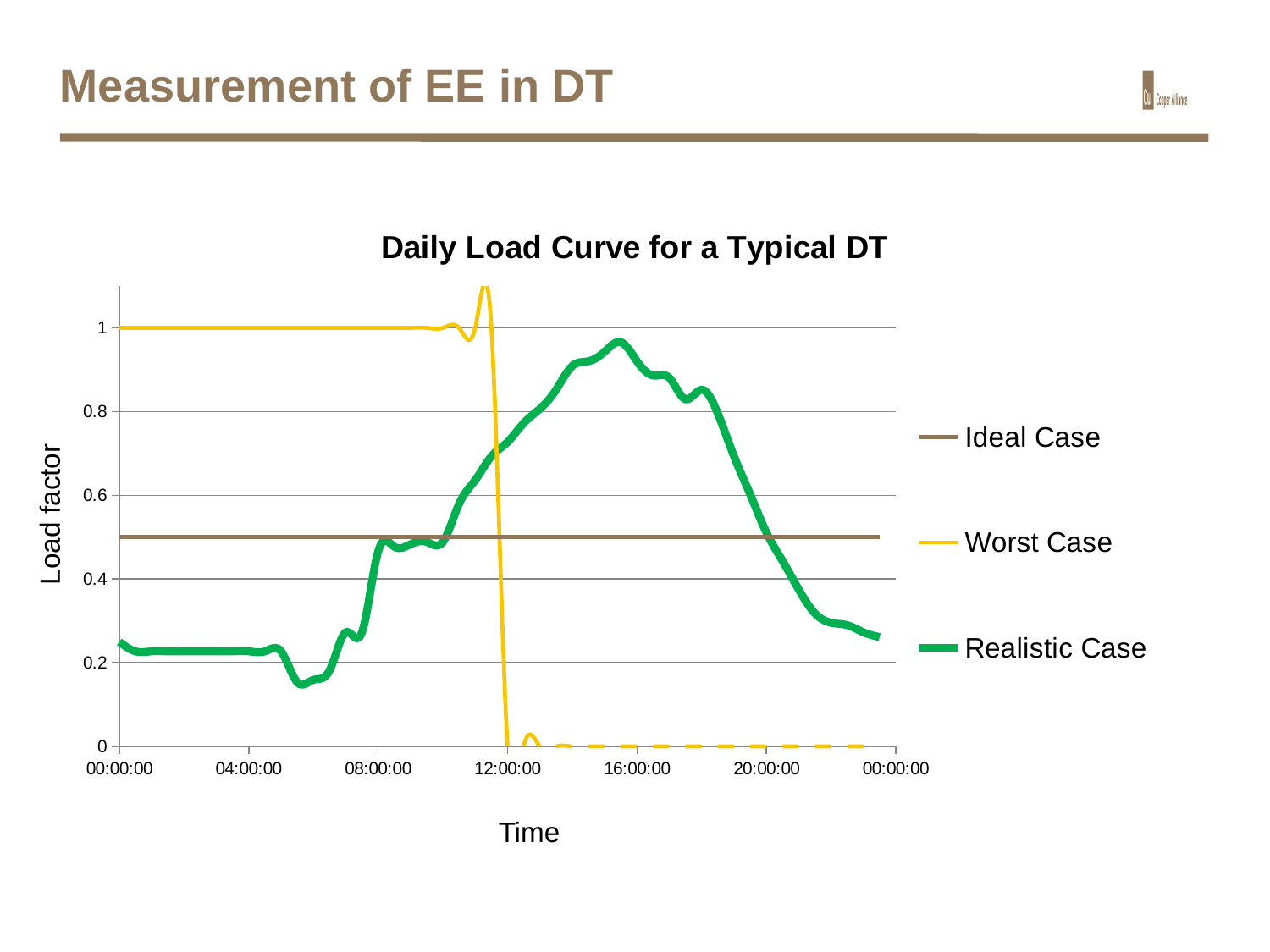
Does the Realistic Case rise or fall between 16:00:00 and 20:00:00? fall What is the load factor of the Worst Case series at 04:00:00? 1 At 04:00:00, which series has the higher load factor, Worst Case or Realistic Case? Worst Case What kind of chart is shown on the slide? line chart What is the label of the vertical axis? Load factor At 16:00:00, which series has the higher load factor, Realistic Case or Ideal Case? Realistic Case How many series does the legend list? 3 Is the value of the Realistic Case at 04:00:00 greater or less than 0.4? less Is the value of the Realistic Case at 16:00:00 greater or less than 0.8? greater What is the load factor of the Worst Case series at 16:00:00? 0 What is the title of the chart? Daily Load Curve for a Typical DT